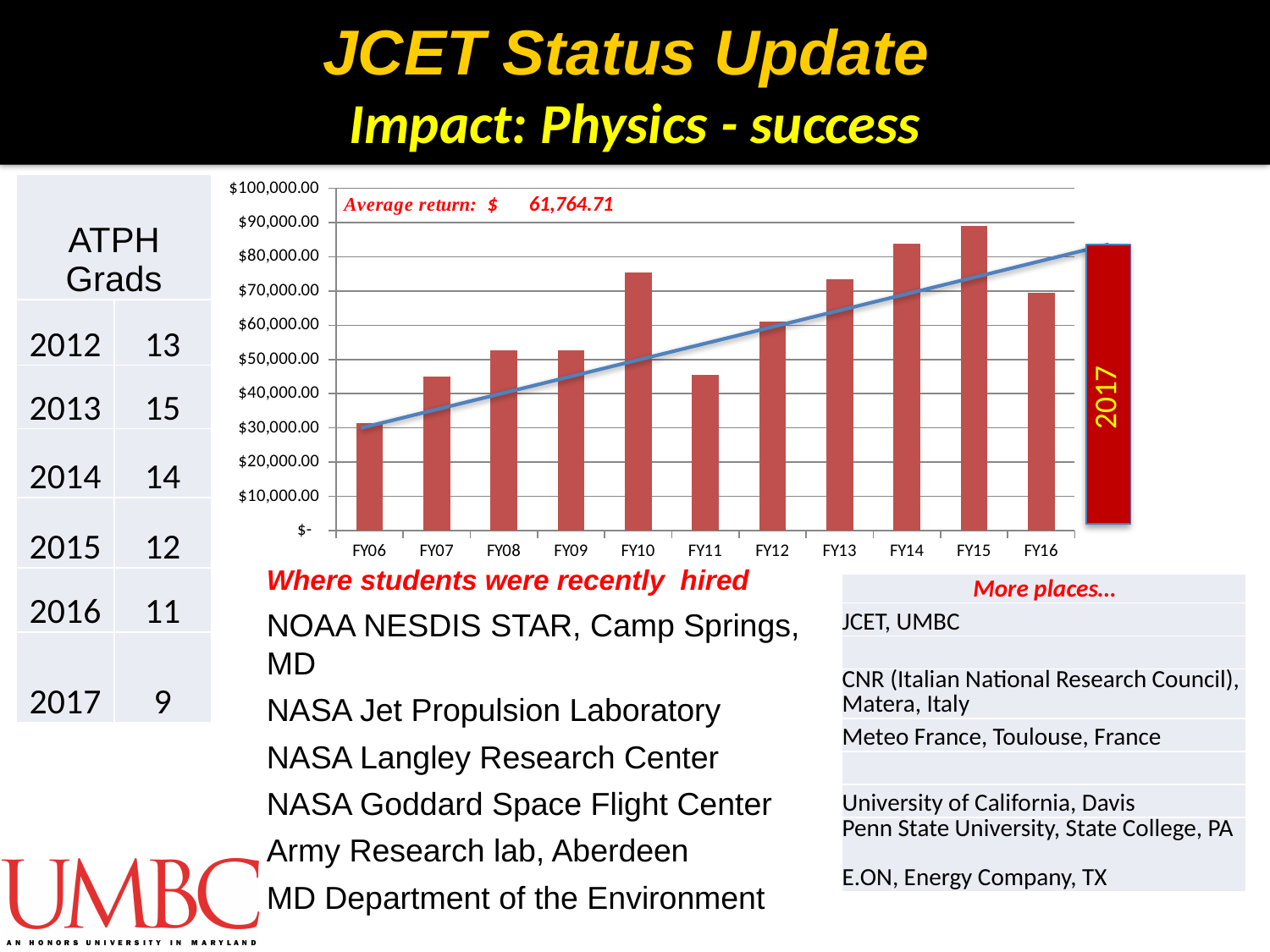
Is the value for FY15 greater or less than $80,000.00? greater Is the value for FY06 greater or less than $40,000.00? less Which fiscal year has the highest bar in the chart? FY15 What average return is printed on the chart? $ 61,764.71 Which is larger, the value for FY10 or the value for FY11? FY10 Is the value for FY10 greater or less than $70,000.00? greater Which fiscal year has the lowest bar in the chart? FY06 Which is larger, the value for FY13 or the value for FY12? FY13 How many fiscal years are labeled on the x axis of the chart? 11 What kind of chart is shown on the slide? bar chart